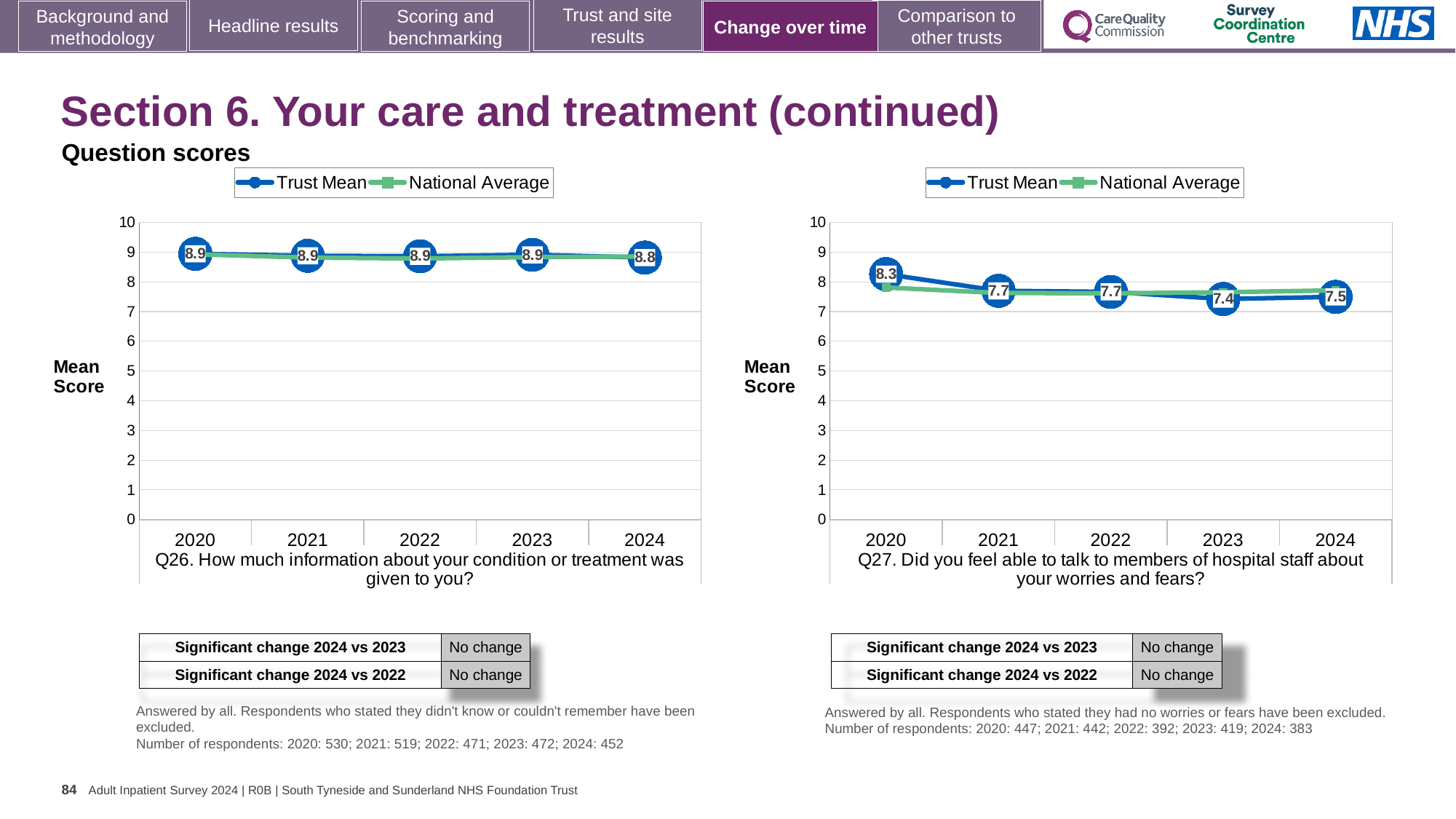
In the Q27 chart on the right, what is the Trust Mean score for 2020? 8.3 In the Q27 chart on the right, which year has the highest Trust Mean score? 2020 In the Q26 chart on the left, which year has the lowest Trust Mean score? 2024 In the Q27 chart on the right, is the National Average value for 2020 greater or less than 7? greater In the Q27 chart on the right, what is the Trust Mean score for 2023? 7.4 In the Q26 chart on the left, what is the Trust Mean score for 2024? 8.8 What type of chart is the Q26 chart on the left? Line chart How many series does the legend of the Q27 chart on the right list? 2 How many years are shown on the x axis of the Q26 chart on the left? 5 In the Q27 chart on the right, is the Trust Mean score higher in 2023 or in 2024? 2024 In the Q27 chart on the right, what is the difference between the Trust Mean scores for 2020 and 2021? 0.6 In the Q27 chart on the right, does the Trust Mean score rise or fall from 2020 to 2023? Fall